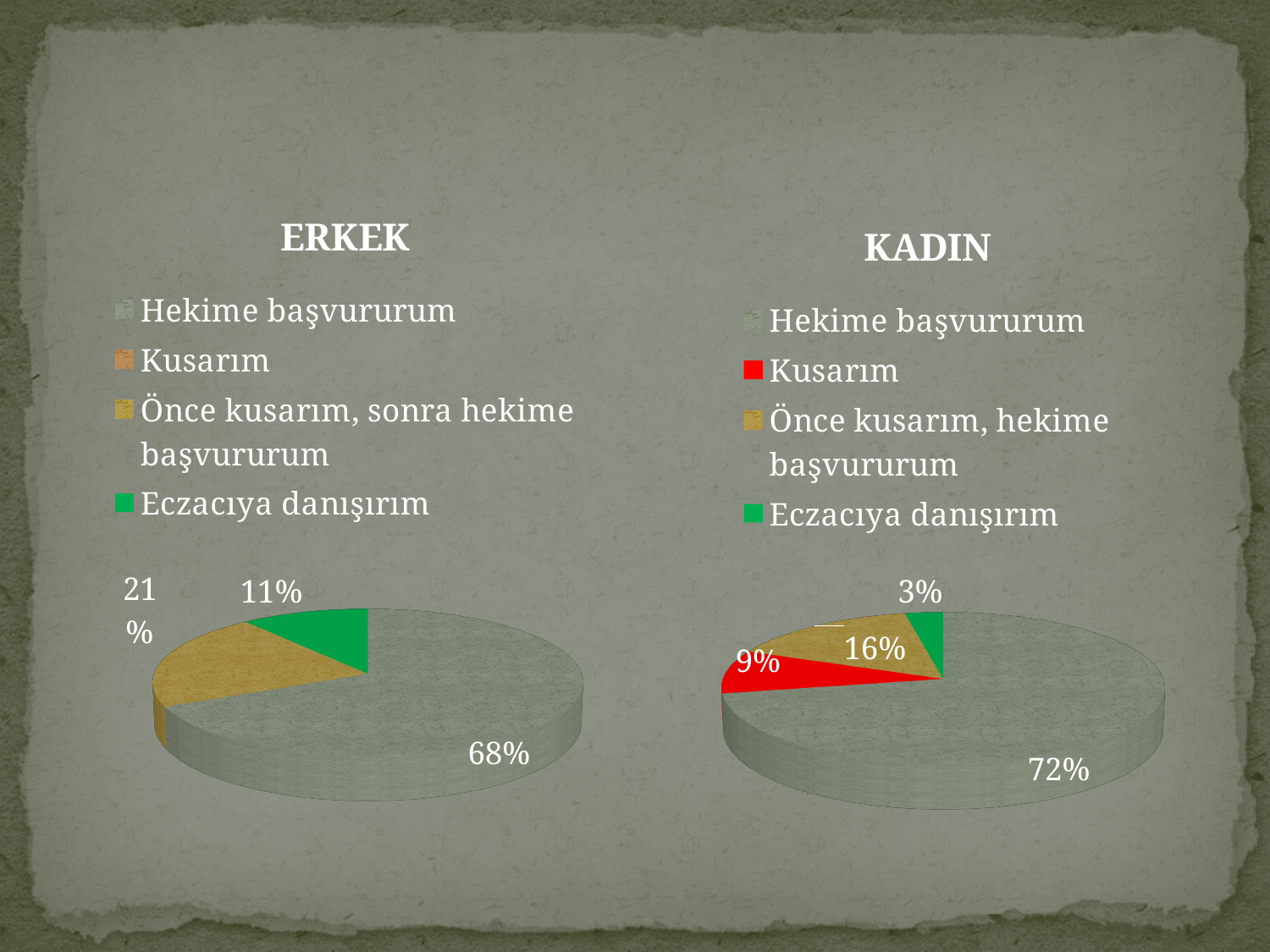
In the ERKEK chart, what percentage is shown for "Eczacıya danışırım"? 11% In the KADIN chart, what percentage is shown for "Eczacıya danışırım"? 3% In the KADIN chart, which category has the largest share? Hekime başvururum In the KADIN chart, what percentage is shown for "Hekime başvururum"? 72% In the KADIN chart, what percentage is shown for "Kusarım"? 9% In the ERKEK chart, what percentage is shown for "Hekime başvururum"? 68% What type of chart is used for the KADIN data? Pie chart In the KADIN chart, which category has the smallest share? Eczacıya danışırım In the ERKEK chart, what percentage is shown for "Önce kusarım, sonra hekime başvururum"? 21% How many entries does the legend of the KADIN chart list? 4 What is the difference between the "Hekime başvururum" share in the KADIN chart and in the ERKEK chart? 4% Which is larger: "Eczacıya danışırım" in the ERKEK chart or in the KADIN chart? ERKEK